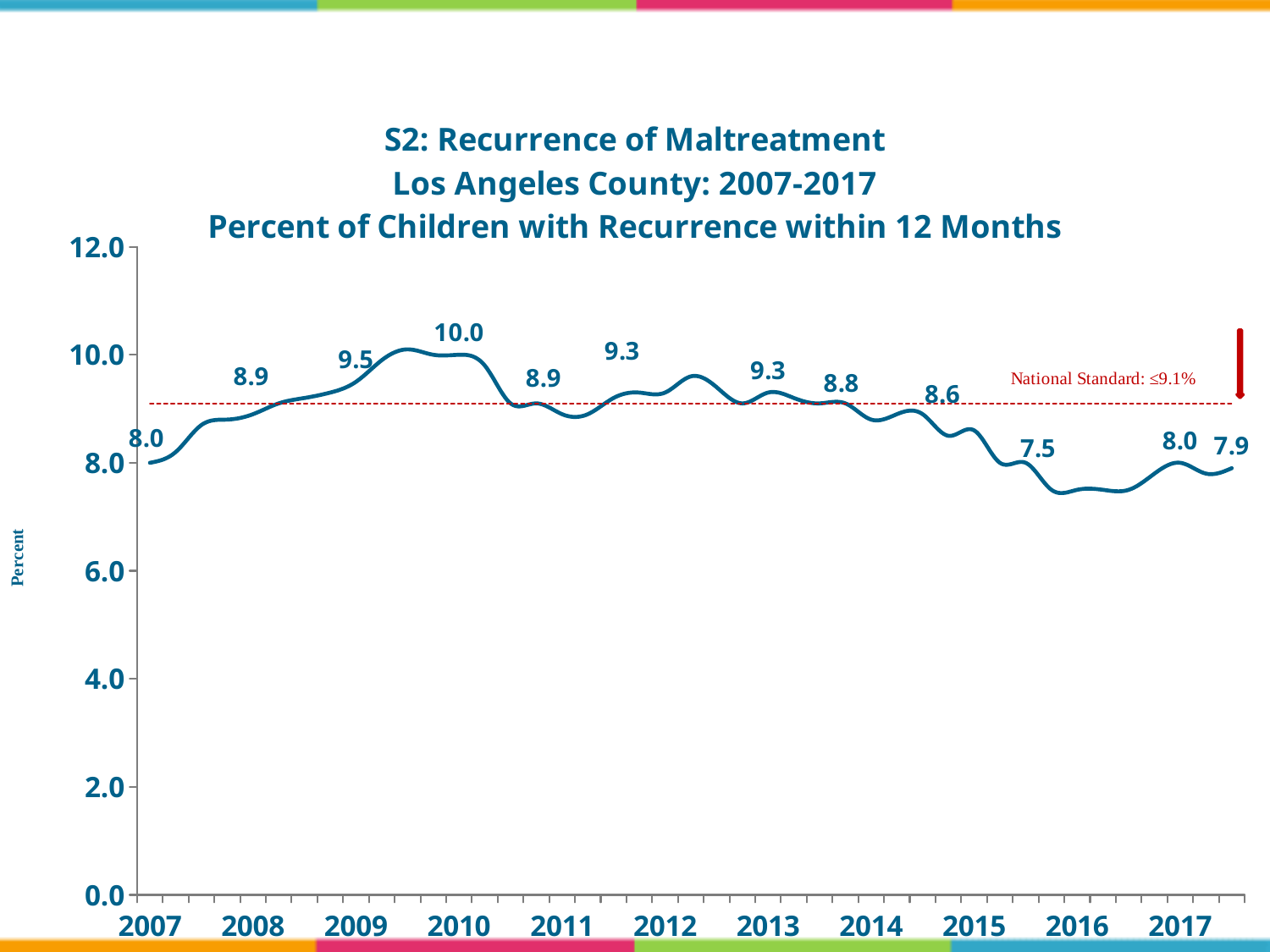
How many years are labeled on the x axis? 11 What was the percent of children with recurrence within 12 months in Los Angeles County in 2010? 10.0 Does the recurrence percent rise or fall from 2013 to 2016? fall What value is labeled for 2007 on the chart? 8.0 Which year has the lowest labeled recurrence percent? 2016 What type of chart is shown on the slide? line chart What is the difference between the 2010 value and the 2016 value? 2.5 What value is labeled for 2015 on the chart? 8.6 Which year has a higher labeled value, 2009 or 2014? 2009 Which year has the highest labeled recurrence percent? 2010 What value is labeled for 2016 on the chart? 7.5 What is the National Standard shown on the chart? ≤9.1%